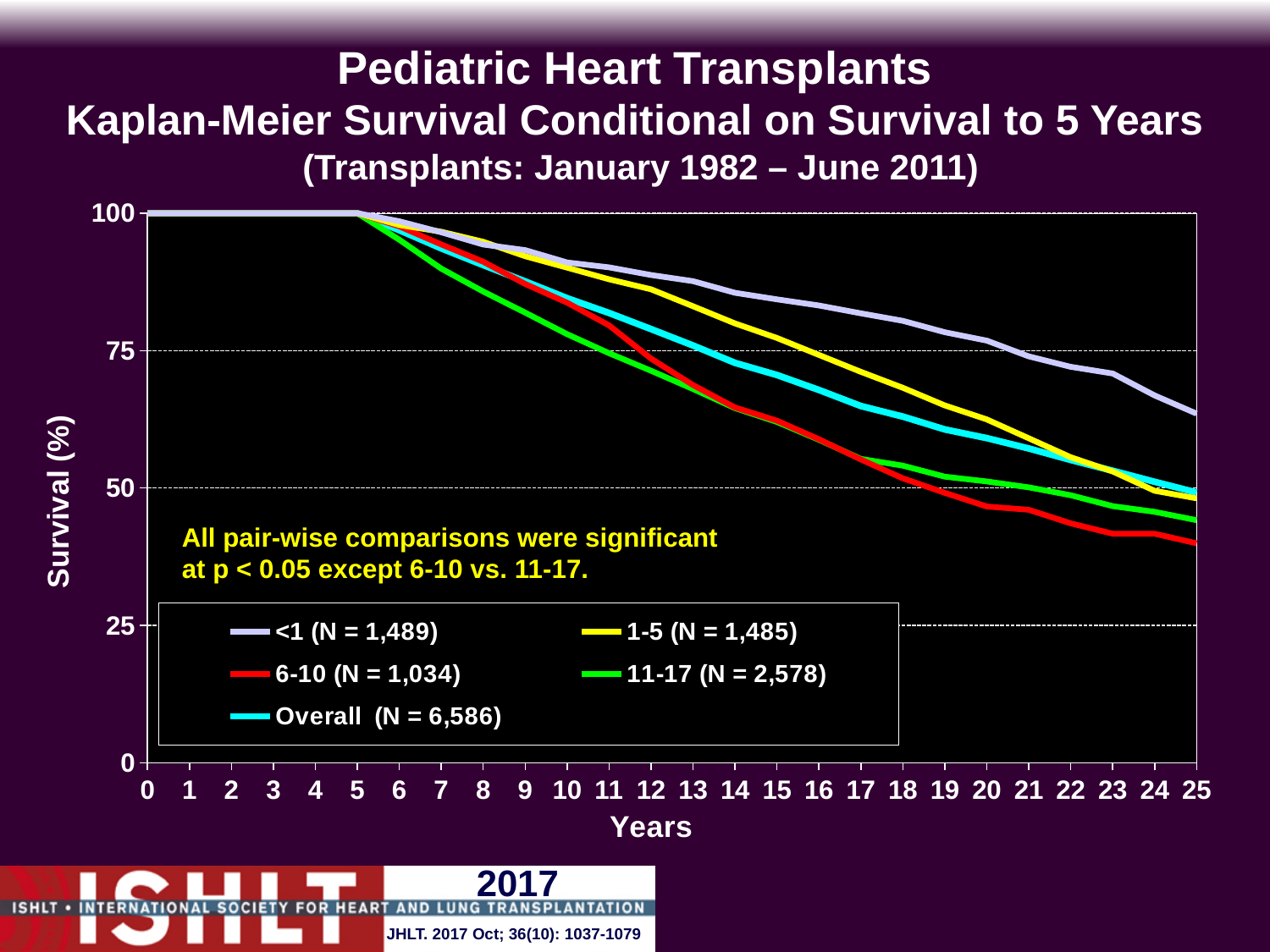
Is the survival for the 11-17 series at year 20 greater or less than 75? less At year 20, which series has higher survival: <1 or 6-10? <1 Is the survival for the 1-5 series at year 12 greater or less than 75? greater Is the survival for the 6-10 series at year 25 greater or less than 50? less What kind of chart is shown on the slide? line chart What is the N for the Overall series in the legend? 6,586 How many series does the legend list? 5 Which series has the highest survival at year 25? <1 (N = 1,489) What is the survival (%) for all series at year 5? 100 Do the survival curves rise or fall along the x axis after year 5? fall Which series has the lowest survival at year 25? 6-10 (N = 1,034)